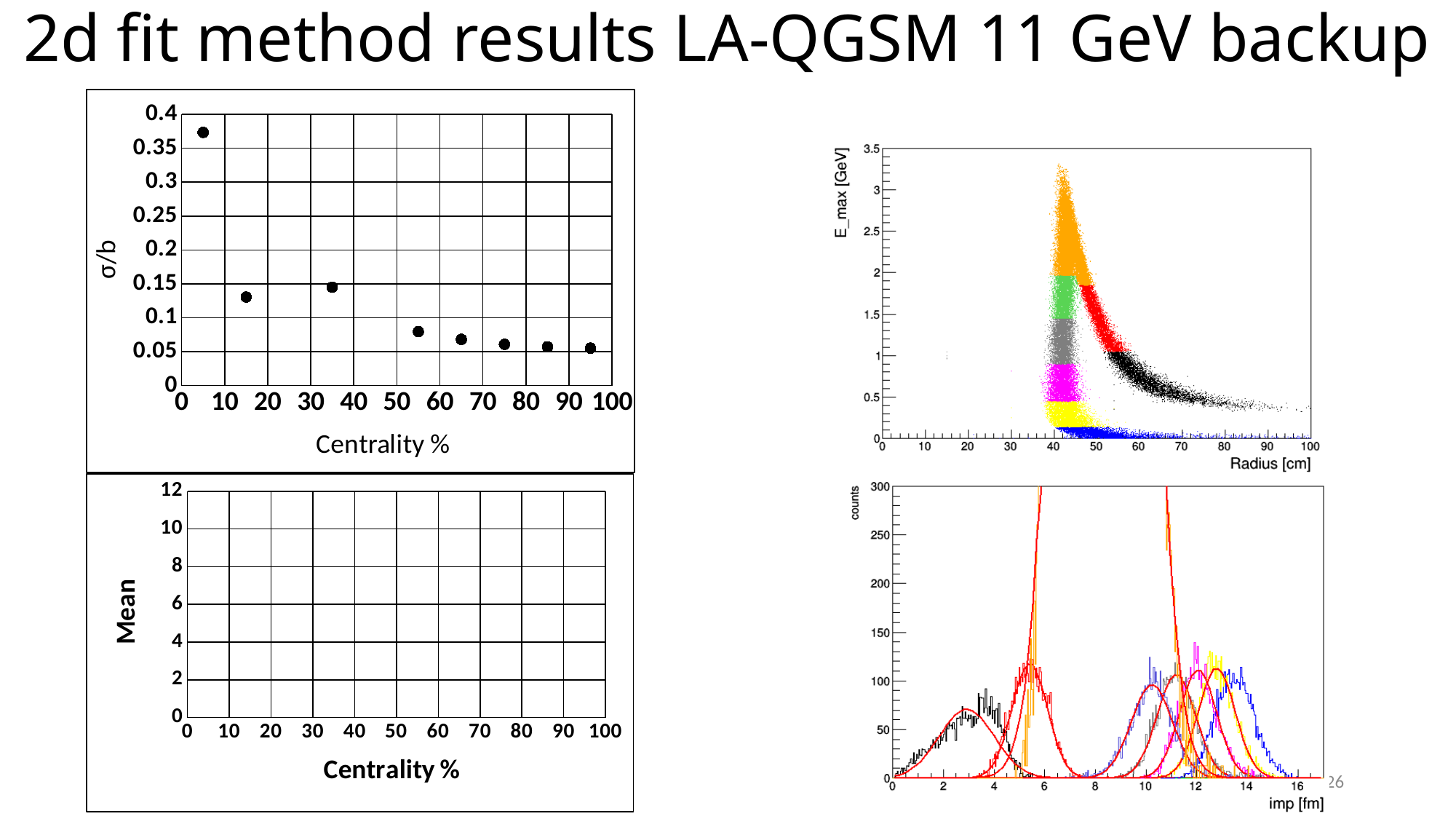
In the bottom-left chart (Mean vs Centrality %), how many data points are plotted? 0 In the top-left chart (σ/b vs Centrality %), is the σ/b value at centrality 55 greater or less than 0.1? less In the top-left chart (σ/b vs Centrality %), is the σ/b value at centrality 15 greater or less than 0.1? greater What is the y-axis label of the bottom-right chart? counts In the top-left chart (σ/b vs Centrality %), do the values rise or fall as centrality increases? fall In the top-left chart (σ/b vs Centrality %), is the σ/b value at centrality 75 greater or less than 0.1? less In the top-left chart (σ/b vs Centrality %), how many data points are plotted? 8 In the top-left chart (σ/b vs Centrality %), at which centrality value is σ/b highest? 5 What type of chart is the top-left chart (σ/b vs Centrality %)? scatter plot What is the x-axis label of the top-right chart? Radius [cm] In the top-left chart (σ/b vs Centrality %), which has the larger σ/b value: centrality 5 or centrality 15? centrality 5